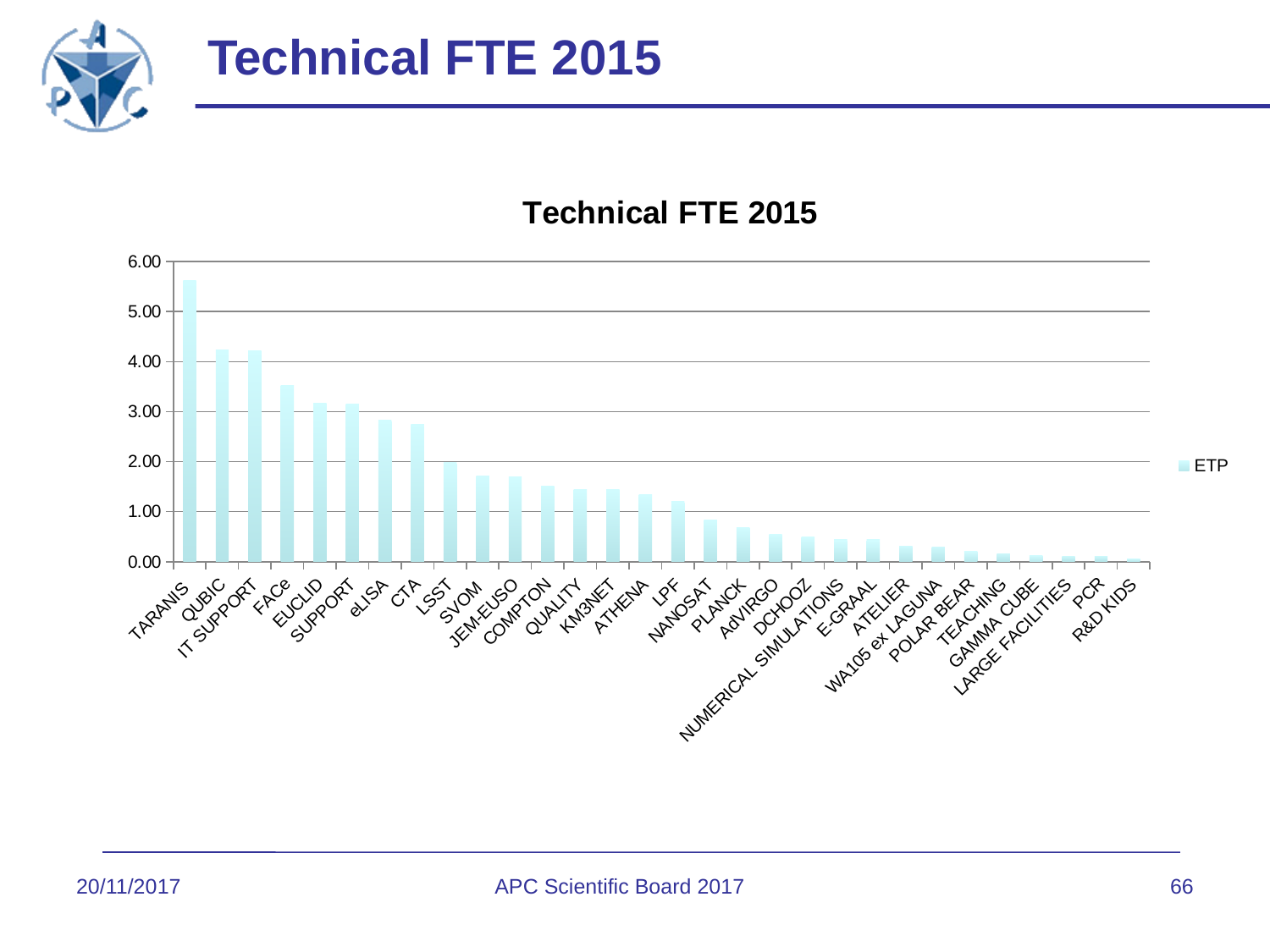
Is the value for ATHENA greater or less than 1.00? greater Is the value for CTA greater or less than 3.00? less Is the value for FACe greater or less than 3.00? greater Which has a larger value, FACe or CTA? FACe Which category has the highest Technical FTE value? TARANIS How many categories are plotted on the x axis? 30 Do the values rise or fall moving from left to right along the x axis? fall What kind of chart is shown on the slide? bar chart What is the single entry shown in the legend? ETP